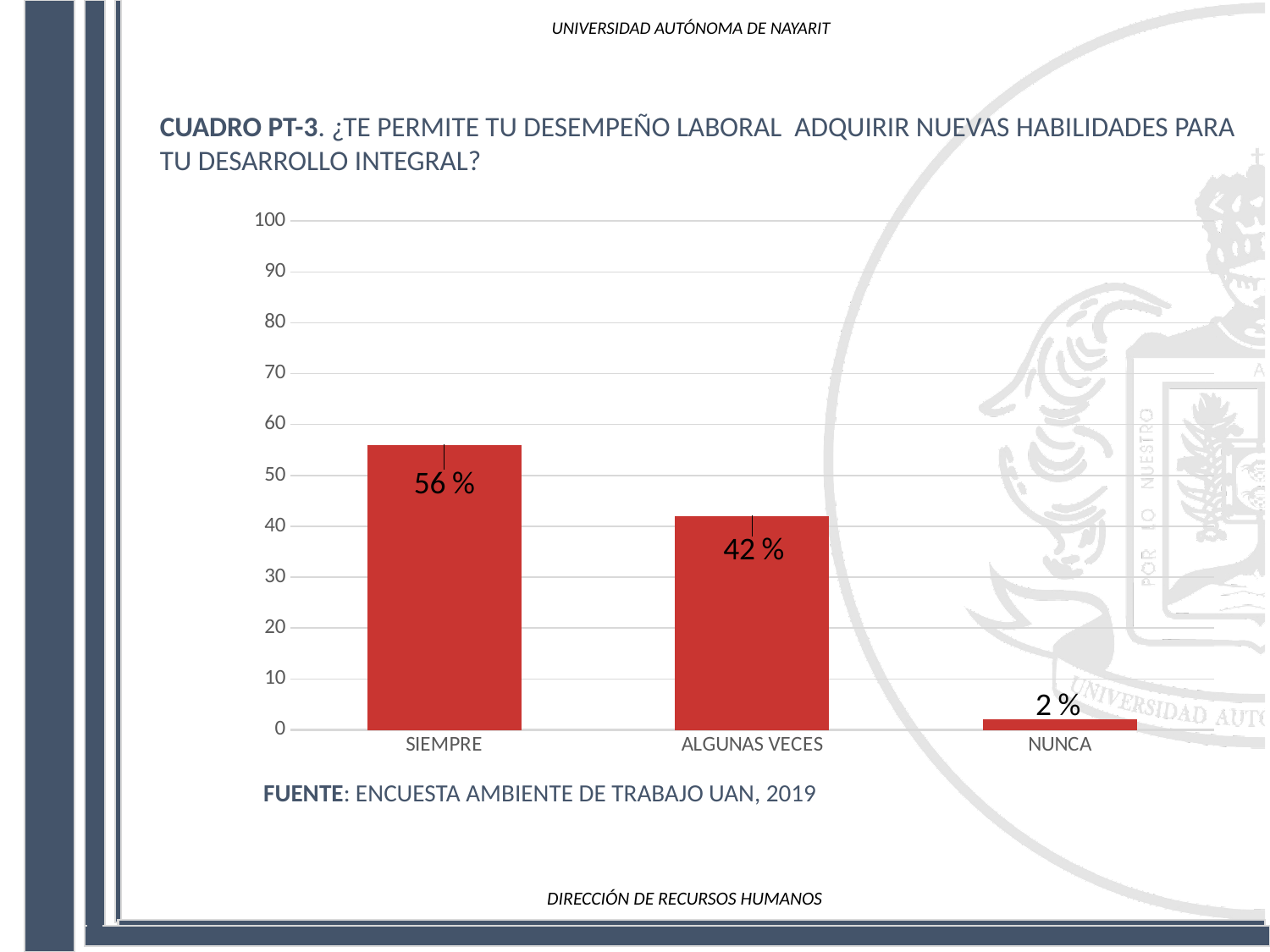
What is the difference between the values for SIEMPRE and ALGUNAS VECES? 14 % Which is larger, the value for SIEMPRE or the value for ALGUNAS VECES? SIEMPRE What is the difference between the values for ALGUNAS VECES and NUNCA? 40 % Is the value for SIEMPRE greater or less than 50? greater What is the value for ALGUNAS VECES? 42 % Which category has the lowest value? NUNCA What source is cited below the chart? ENCUESTA AMBIENTE DE TRABAJO UAN, 2019 What is the value for SIEMPRE? 56 % What kind of chart is shown on the slide? bar chart Which category has the highest value? SIEMPRE How many categories are shown on the x axis? 3 What is the value for NUNCA? 2 %